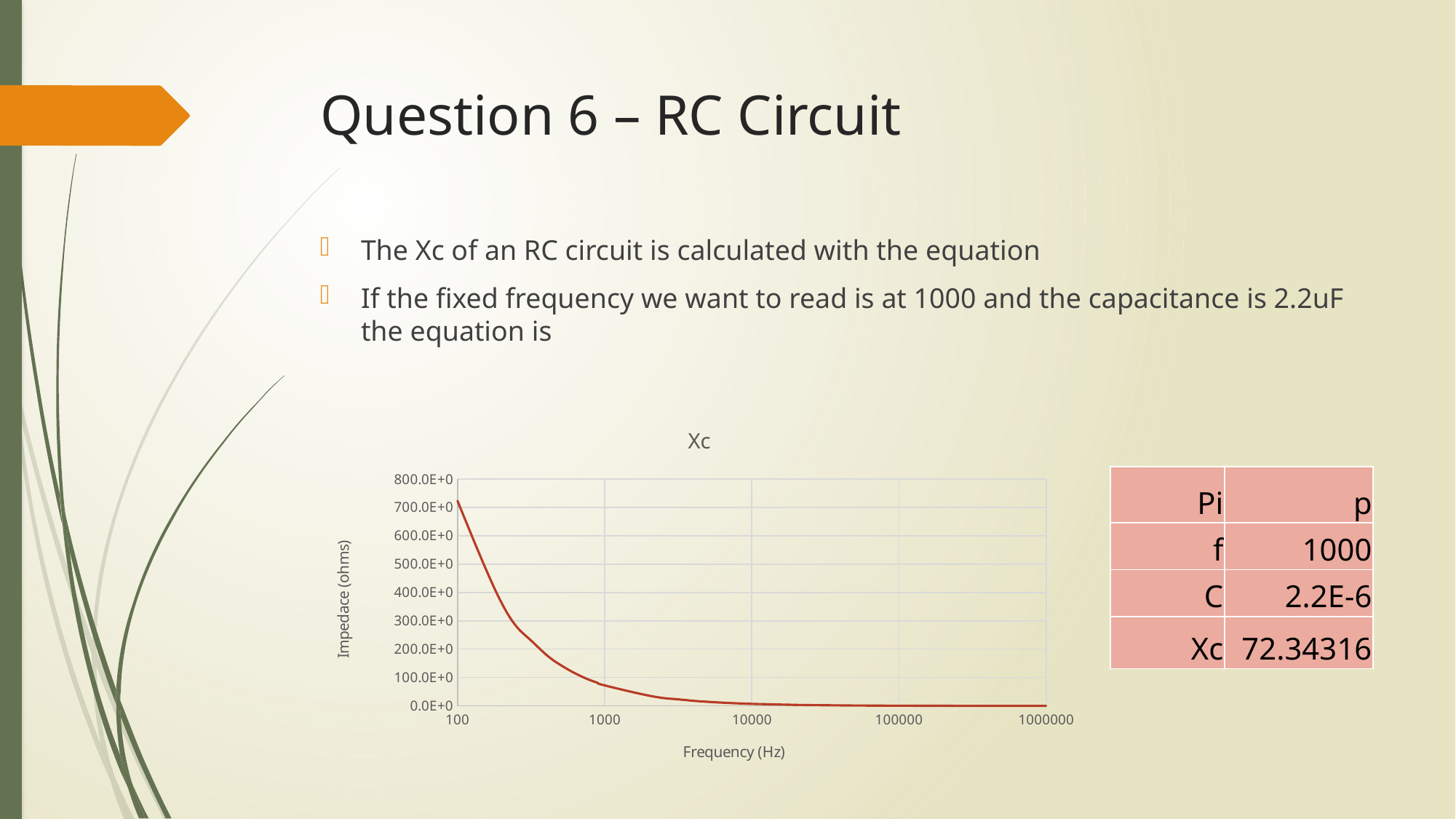
What is the label of the x axis of the chart? Frequency (Hz) Is the impedance value at 10000 Hz greater or less than 100.0E+0? less At which frequency shown on the x axis is the impedance highest? 100 What is the title of the chart? Xc What is the highest value shown on the y axis? 800.0E+0 Is the impedance value at 100 Hz greater or less than 600.0E+0? greater What kind of chart is shown on the slide? line chart Does the impedance rise or fall as frequency increases along the x axis? fall How many frequency tick labels are shown on the x axis? 5 Which has the larger impedance, 100 Hz or 1000 Hz? 100 Hz Is the impedance value at 1000 Hz greater or less than 100.0E+0? less